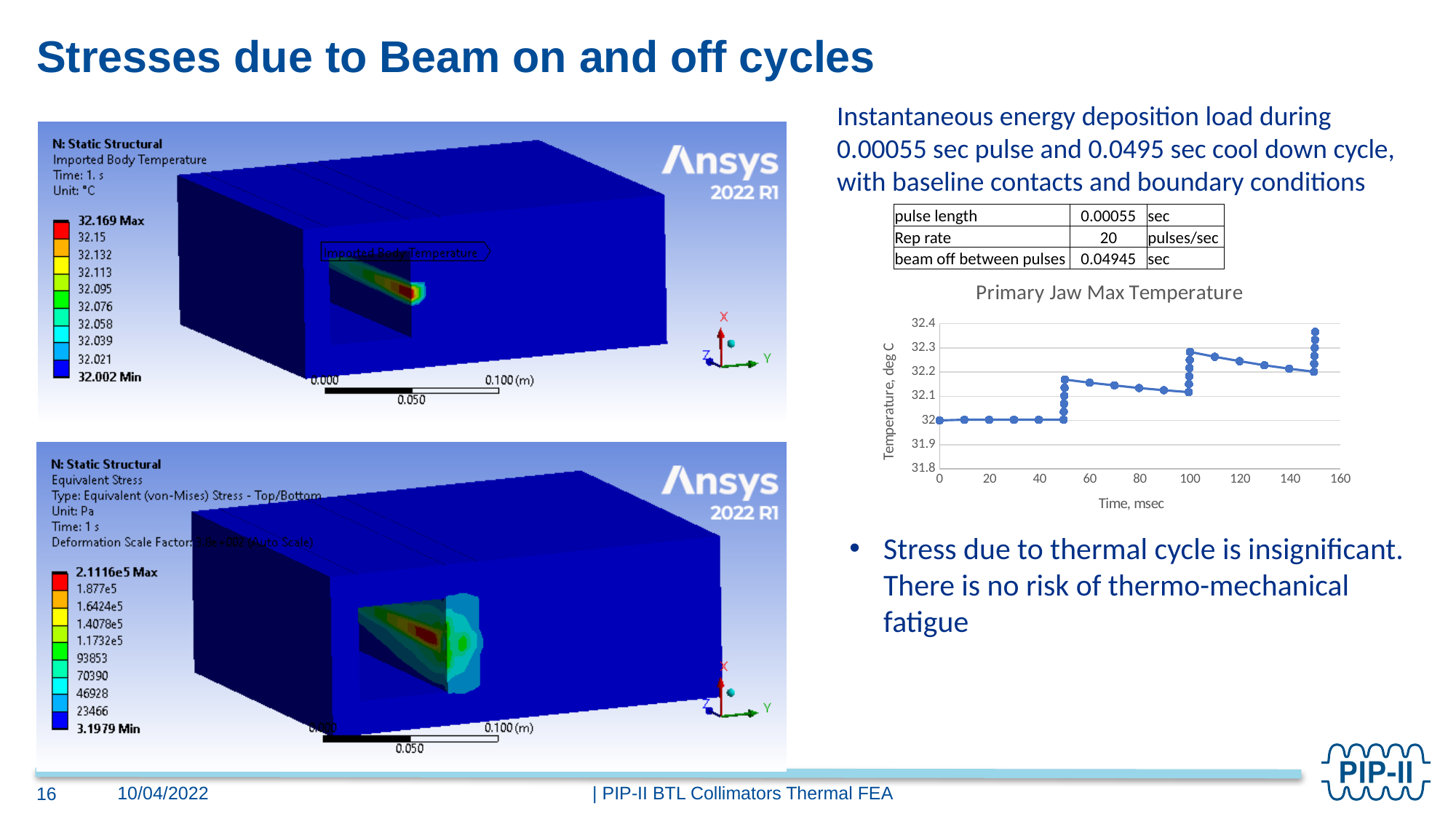
What kind of chart is the "Primary Jaw Max Temperature" chart? line chart with markers In the "Primary Jaw Max Temperature" chart, what is the highest value shown on the x axis? 160 What is the title of the chart on the right side of the slide? Primary Jaw Max Temperature In the "Primary Jaw Max Temperature" chart, what is the temperature at time 0 msec? 32 In the "Primary Jaw Max Temperature" chart, is the temperature at 60 msec greater or less than 32.1? greater In the "Primary Jaw Max Temperature" chart, does the temperature overall rise or fall as time increases? rise In the "Primary Jaw Max Temperature" chart, which is larger: the temperature at 150 msec or the temperature at 50 msec? 150 msec In the "Primary Jaw Max Temperature" chart, is the temperature at 150 msec greater or less than 32.3? greater In the "Primary Jaw Max Temperature" chart, is the temperature at 20 msec greater or less than 32.1? less What is the x-axis label of the "Primary Jaw Max Temperature" chart? Time, msec In the "Primary Jaw Max Temperature" chart, at which time is the temperature highest? 150 msec